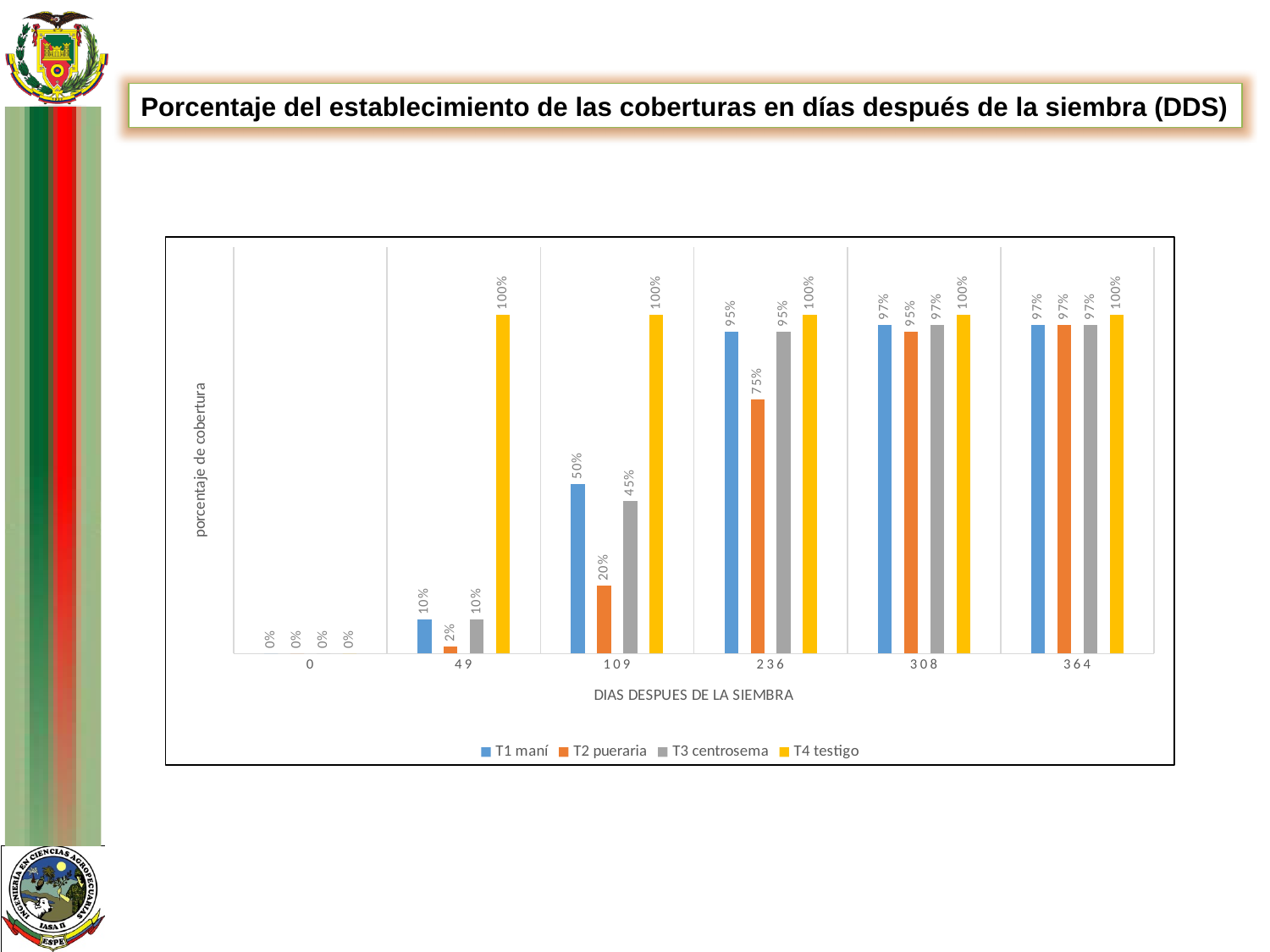
What is the value for T2 pueraria at 236 days after sowing? 75% Which series has the highest value at 49 days after sowing? T4 testigo What is the difference between T1 maní and T2 pueraria at 109 days after sowing? 30% What kind of chart is shown on the slide? bar chart What is the value for T3 centrosema at 109 days after sowing? 45% How many series does the legend list? 4 How many categories are shown on the x axis (DIAS DESPUES DE LA SIEMBRA)? 6 Which series has the lowest value at 109 days after sowing? T2 pueraria Do the values for T2 pueraria rise or fall as days after sowing increase? rise What is the value for T2 pueraria at 49 days after sowing? 2% Which is larger at 236 days after sowing: T1 maní or T2 pueraria? T1 maní What is the label of the y axis? porcentaje de cobertura